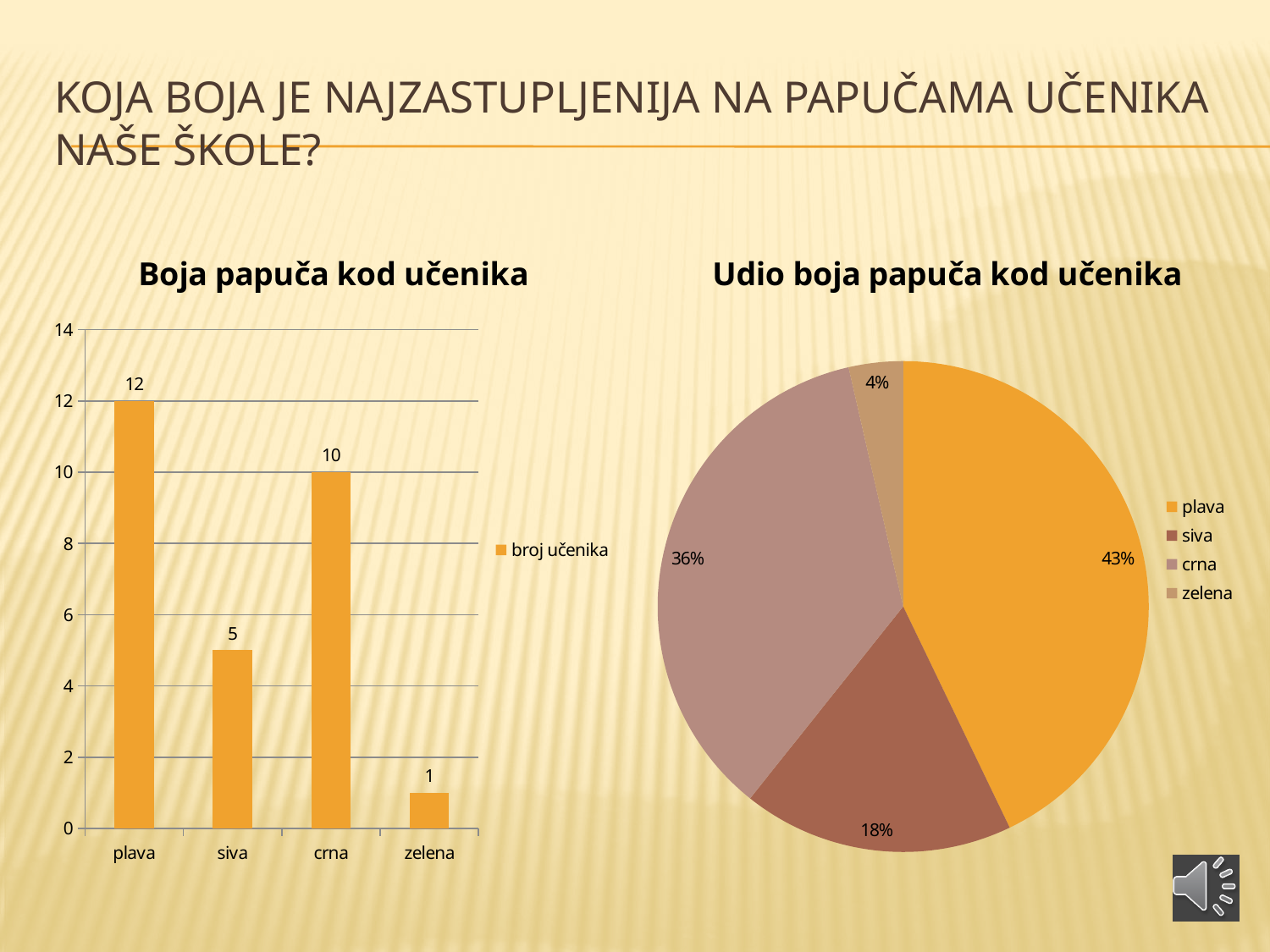
How many entries does the legend of the 'Udio boja papuča kod učenika' chart list? 4 In the 'Boja papuča kod učenika' chart, which category has the lowest value? zelena What kind of chart is 'Boja papuča kod učenika'? bar chart What is the legend entry of the 'Boja papuča kod učenika' chart? broj učenika In the 'Udio boja papuča kod učenika' chart, what share does crna have? 36% In the 'Boja papuča kod učenika' chart, what is the difference between the values for plava and crna? 2 In the 'Boja papuča kod učenika' chart, how many categories are shown on the x axis? 4 In the 'Boja papuča kod učenika' chart, what is the value for plava? 12 In the 'Udio boja papuča kod učenika' chart, what share does zelena have? 4% In the 'Boja papuča kod učenika' chart, which category has the highest value? plava In the 'Boja papuča kod učenika' chart, which is larger, the value for siva or the value for crna? crna In the 'Boja papuča kod učenika' chart, what is the value for siva? 5